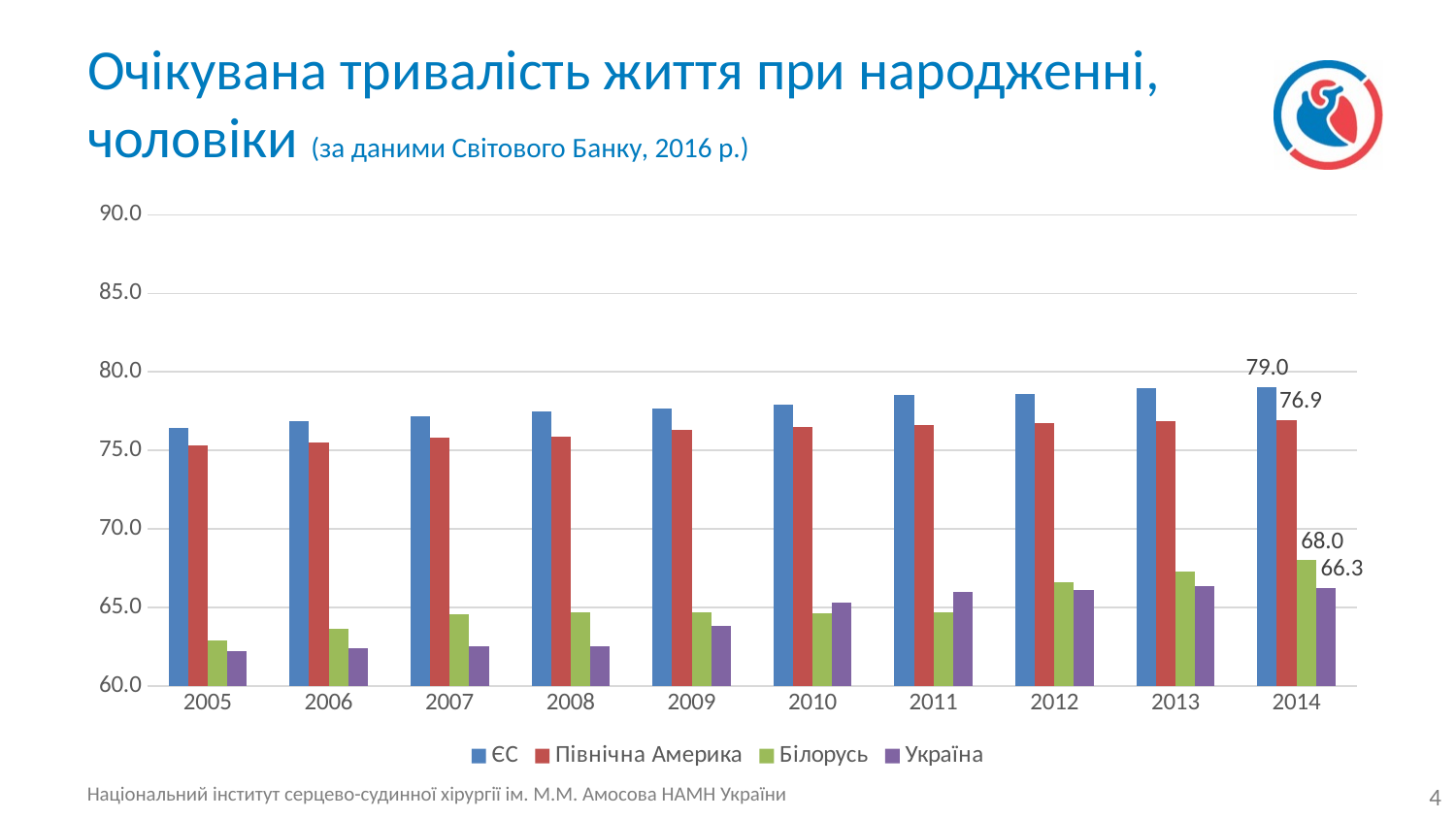
Is the value for Україна in 2005 greater or less than 65.0? less How many series does the legend list? 4 What is the value for Північна Америка in 2014? 76.9 What is the difference between the Білорусь and Україна values in 2014? 1.7 How many years are shown on the x axis? 10 Which series has the lowest value in 2005? Україна What is the value for Білорусь in 2014? 68.0 Which series has the highest value in 2014? ЄС What kind of chart is shown on the slide? bar chart What is the value for ЄС in 2014? 79.0 What is the difference between the ЄС and Україна values in 2014? 12.7 What is the value for Україна in 2014? 66.3